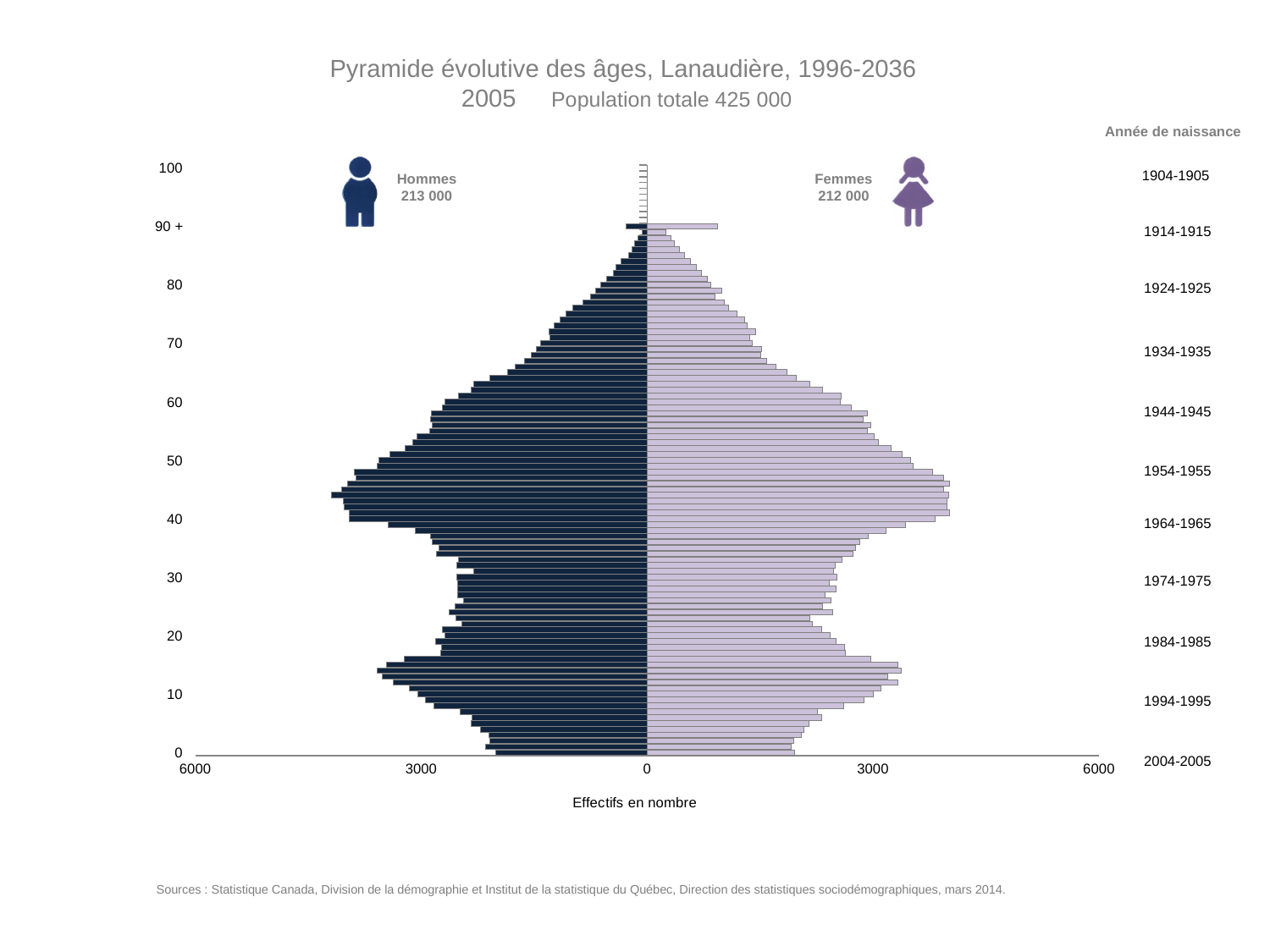
What is the number of Hommes shown on the chart? 213 000 What total population is shown for 2005? 425 000 How many series (population groups) does the chart show? 2 What is the number of Femmes shown on the chart? 212 000 Is the value for Hommes at age 0 greater or less than 3000? less What is the title of the chart? Pyramide évolutive des âges, Lanaudière, 1996-2036 What is the difference between the Hommes total and the Femmes total? 1 000 Which group has the larger total, Hommes or Femmes? Hommes What is the label of the horizontal axis? Effectifs en nombre What kind of chart is shown on the slide? bar chart Is the value for Hommes at age 45 greater or less than 3000? greater Is the value for Femmes at age 80 greater or less than 3000? less